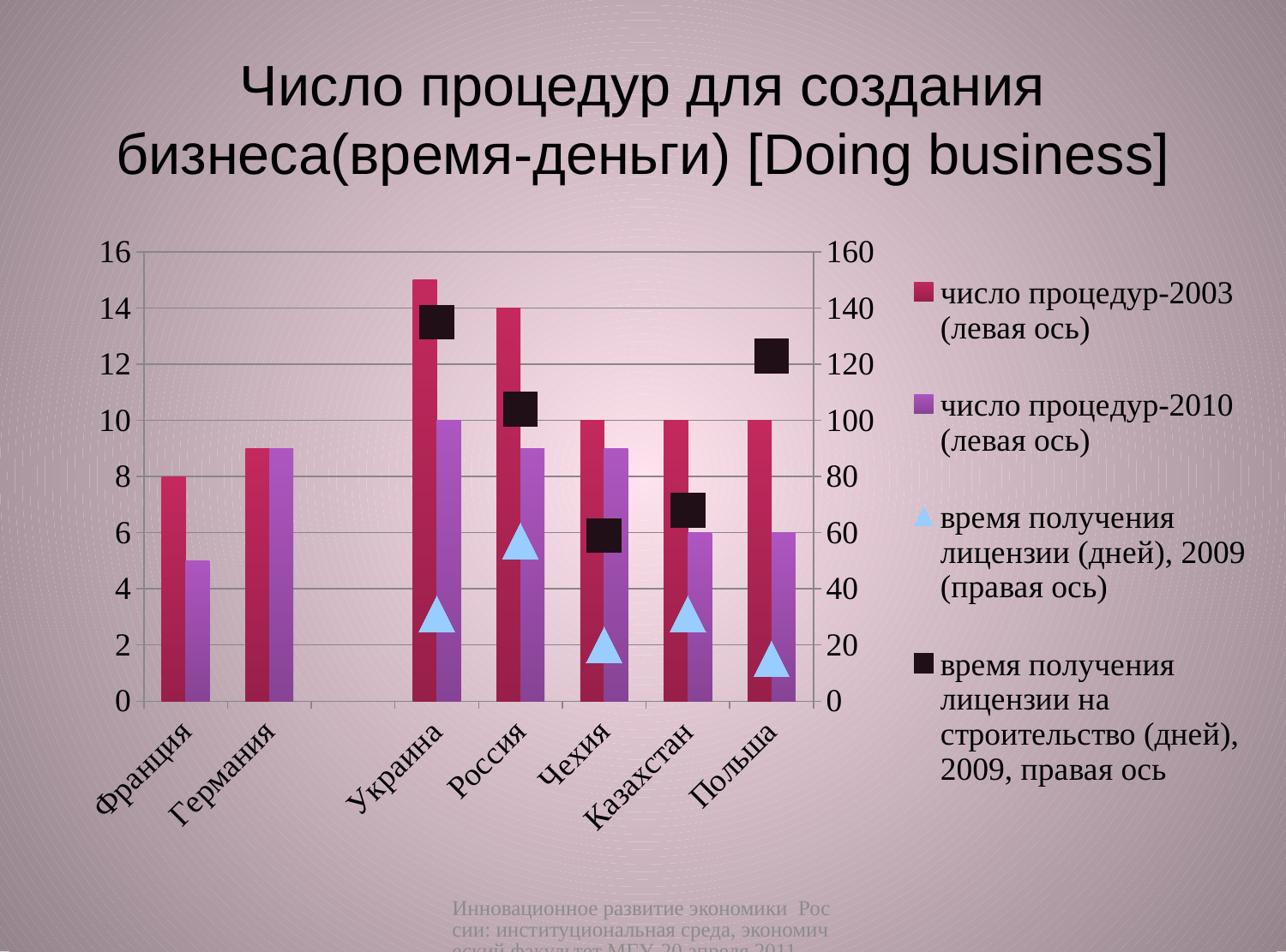
What is the value of число процедур-2010 for Украина? 10 Which country has the lowest value for число процедур-2003? Франция What is the value of число процедур-2010 for Казахстан? 6 What is the difference between число процедур-2003 and число процедур-2010 for Казахстан? 4 Is the value of время получения лицензии на строительство (дней), 2009 for Украина greater or less than 120? greater What kind of chart is shown on the slide? bar chart What is the value of число процедур-2003 for Франция? 8 How many series does the legend list? 4 How many countries are shown on the x axis? 7 What is the value of число процедур-2003 for Россия? 14 Which country has the highest value for число процедур-2003? Украина